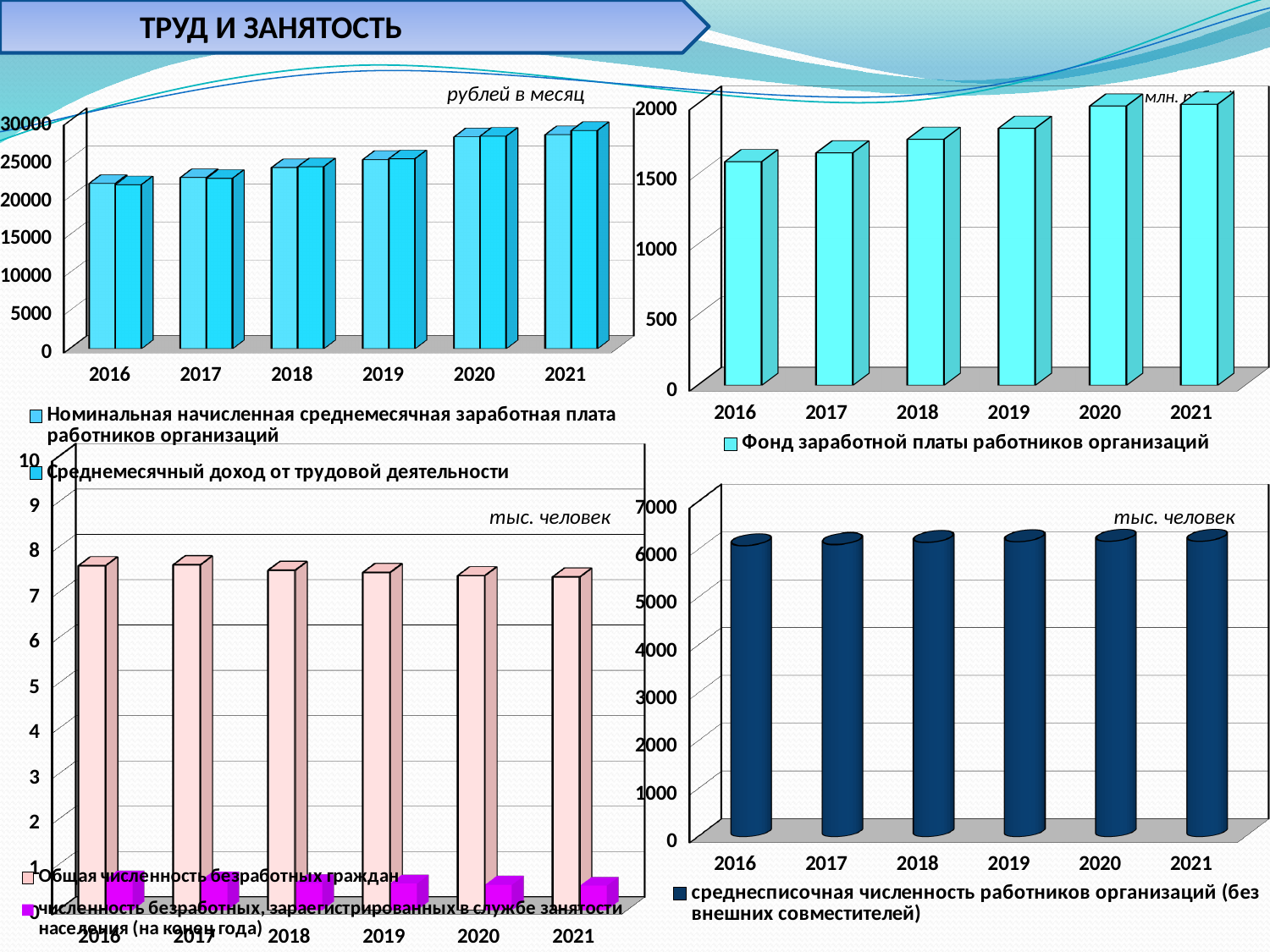
In the top-left chart (рублей в месяц), is the value for Номинальная начисленная среднемесячная заработная плата in 2016 greater or less than 20000? greater How many series does the legend of the top-left chart (рублей в месяц) list? 2 In the top-right chart (Фонд заработной платы работников организаций), which year has the lowest value? 2016 In the top-left chart (рублей в месяц), do the values for Среднемесячный доход от трудовой деятельности rise or fall from 2016 to 2021? rise What kind of chart is the top-left chart (рублей в месяц)? bar chart In the bottom-left chart (тыс. человек, unemployed), which series is larger in 2016: Общая численность безработных граждан or численность безработных, зарегистрированных в службе занятости населения? Общая численность безработных граждан In the bottom-left chart (тыс. человек, unemployed), is the value for Общая численность безработных граждан in 2016 greater or less than 7? greater In the top-left chart (рублей в месяц), which year has the lowest value for Номинальная начисленная среднемесячная заработная плата работников организаций? 2016 In the top-right chart (Фонд заработной платы работников организаций), is the value for 2018 greater or less than 1500? greater What unit is stated on the bottom-right chart (среднесписочная численность работников организаций)? тыс. человек How many years are shown on the x axis of the top-right chart (Фонд заработной платы работников организаций)? 6